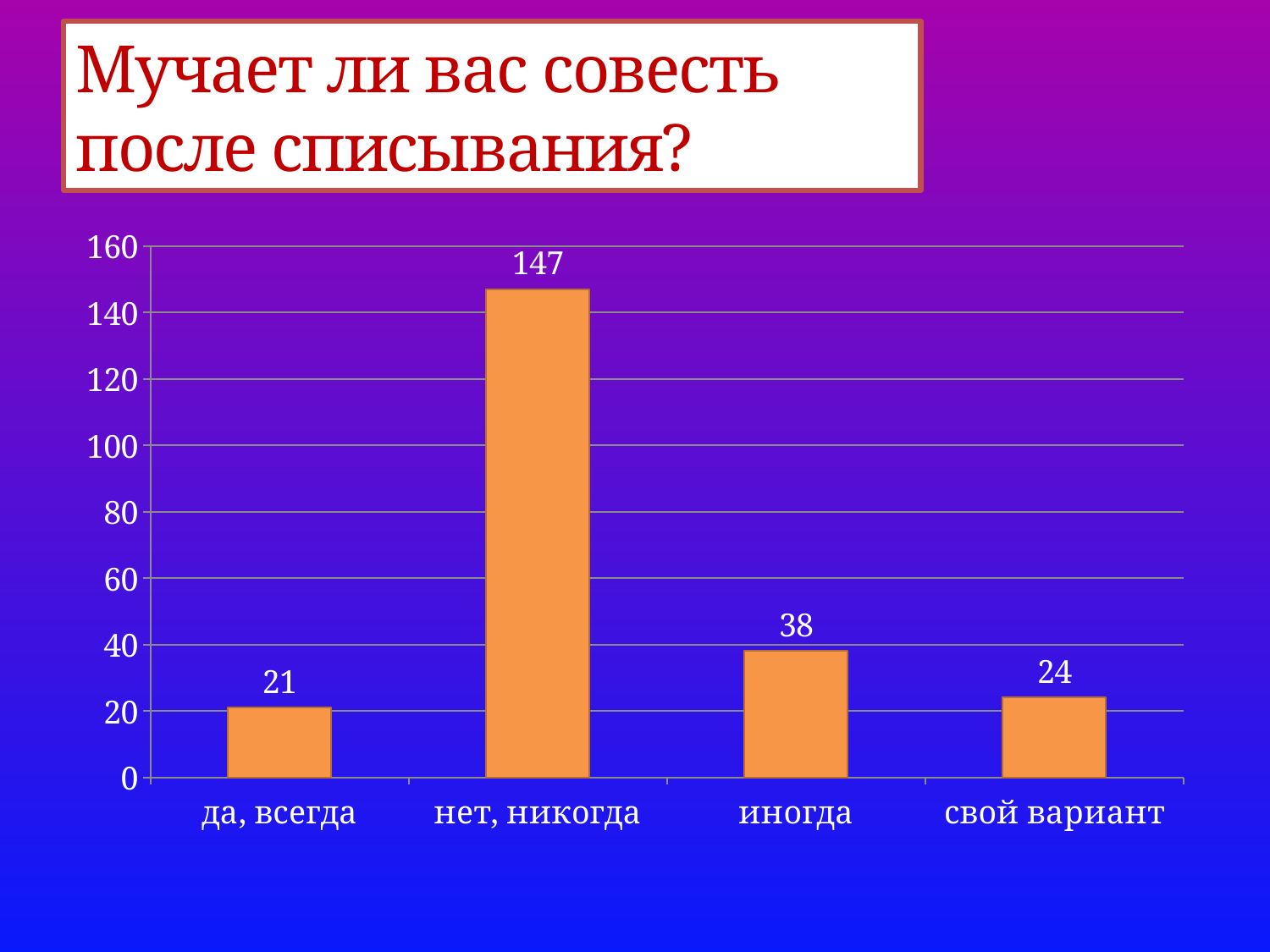
How many categories are shown on the x axis? 4 What is the value for "нет, никогда"? 147 Which category has the highest value? нет, никогда What is the title of the slide above the chart? Мучает ли вас совесть после списывания? What kind of chart is shown on the slide? bar chart What is the difference between the values for "нет, никогда" and "иногда"? 109 What is the difference between the values for "свой вариант" and "да, всегда"? 3 Which category has the lowest value? да, всегда What is the value for "иногда"? 38 Which is larger, the value for "иногда" or the value for "свой вариант"? иногда What is the value for "свой вариант"? 24 What is the value for "да, всегда"? 21